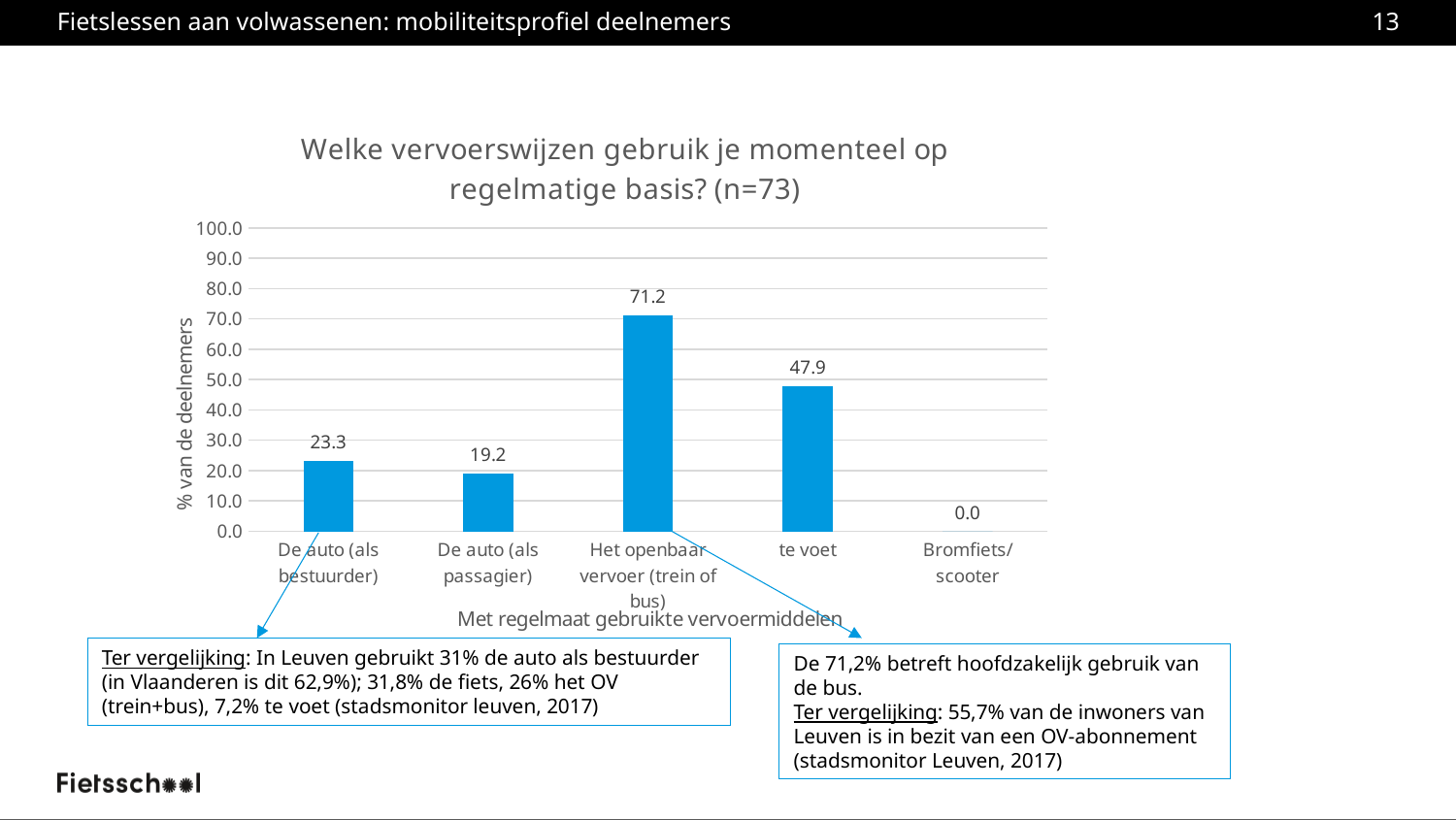
What is the value for 'Bromfiets/scooter'? 0.0 What is the value for 'te voet'? 47.9 Which category has the highest value? Het openbaar vervoer (trein of bus) What is the difference between the values for 'Het openbaar vervoer (trein of bus)' and 'te voet'? 23.3 Is the value for 'te voet' greater or less than 50.0? less How many categories are shown on the x axis? 5 What is the label of the y axis? % van de deelnemers What kind of chart is shown on the slide? bar chart What is the value for 'De auto (als passagier)'? 19.2 Which category has the lowest value? Bromfiets/scooter What is the value for 'Het openbaar vervoer (trein of bus)'? 71.2 Which is larger, the value for 'De auto (als bestuurder)' or 'De auto (als passagier)'? De auto (als bestuurder)